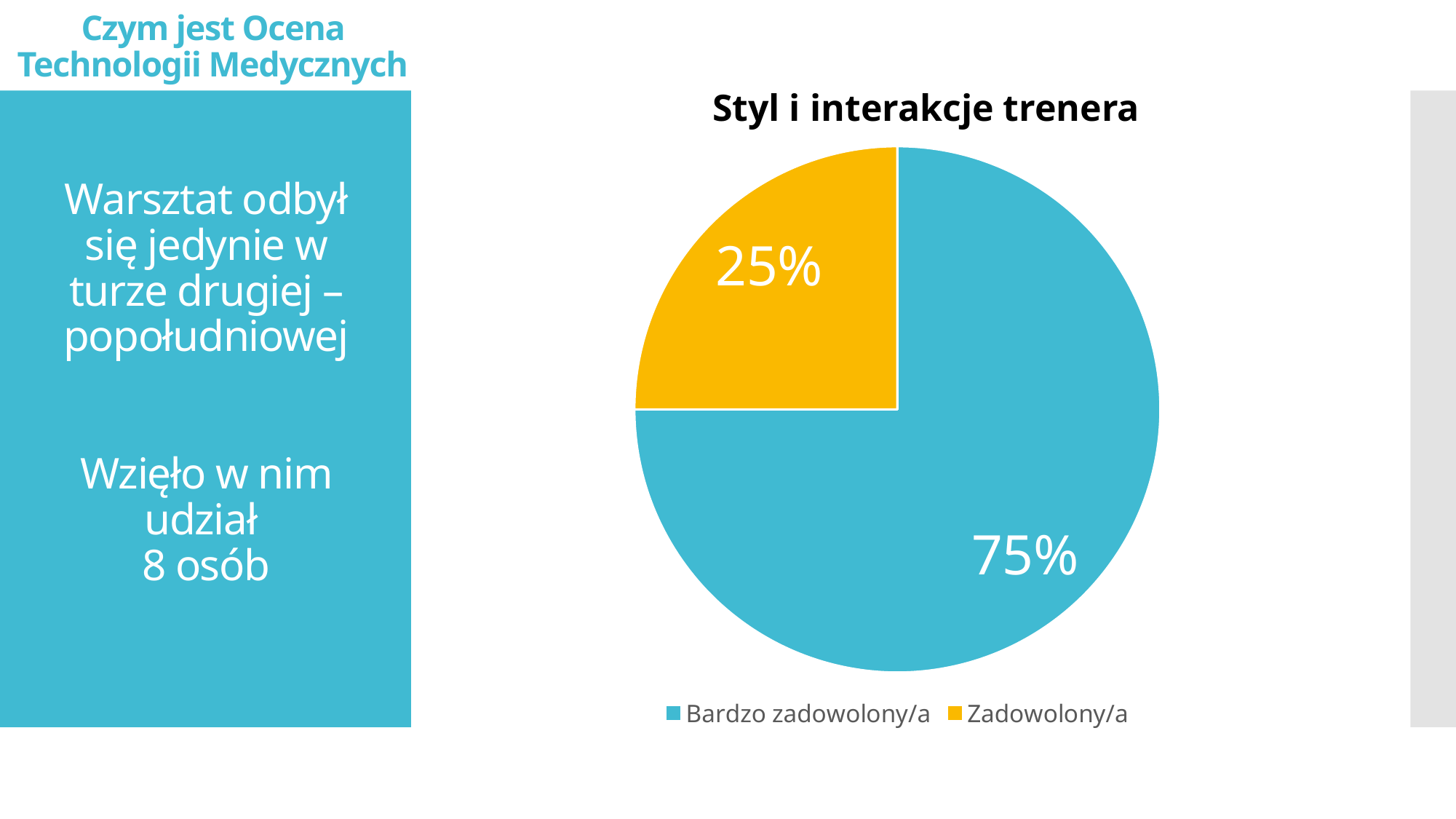
What share of the pie is labelled "Zadowolony/a"? 25% Which category has the largest slice of the pie? Bardzo zadowolony/a What is the difference in percentage points between the "Bardzo zadowolony/a" and "Zadowolony/a" slices? 50 percentage points How many slices does the pie chart have? 2 What colour is the "Zadowolony/a" slice? yellow How many entries does the legend list? 2 What share of the pie is labelled "Bardzo zadowolony/a"? 75% Which category has the smallest slice of the pie? Zadowolony/a What type of chart is shown on the slide? pie chart Which slice is larger, "Bardzo zadowolony/a" or "Zadowolony/a"? Bardzo zadowolony/a What is the title of the chart? Styl i interakcje trenera